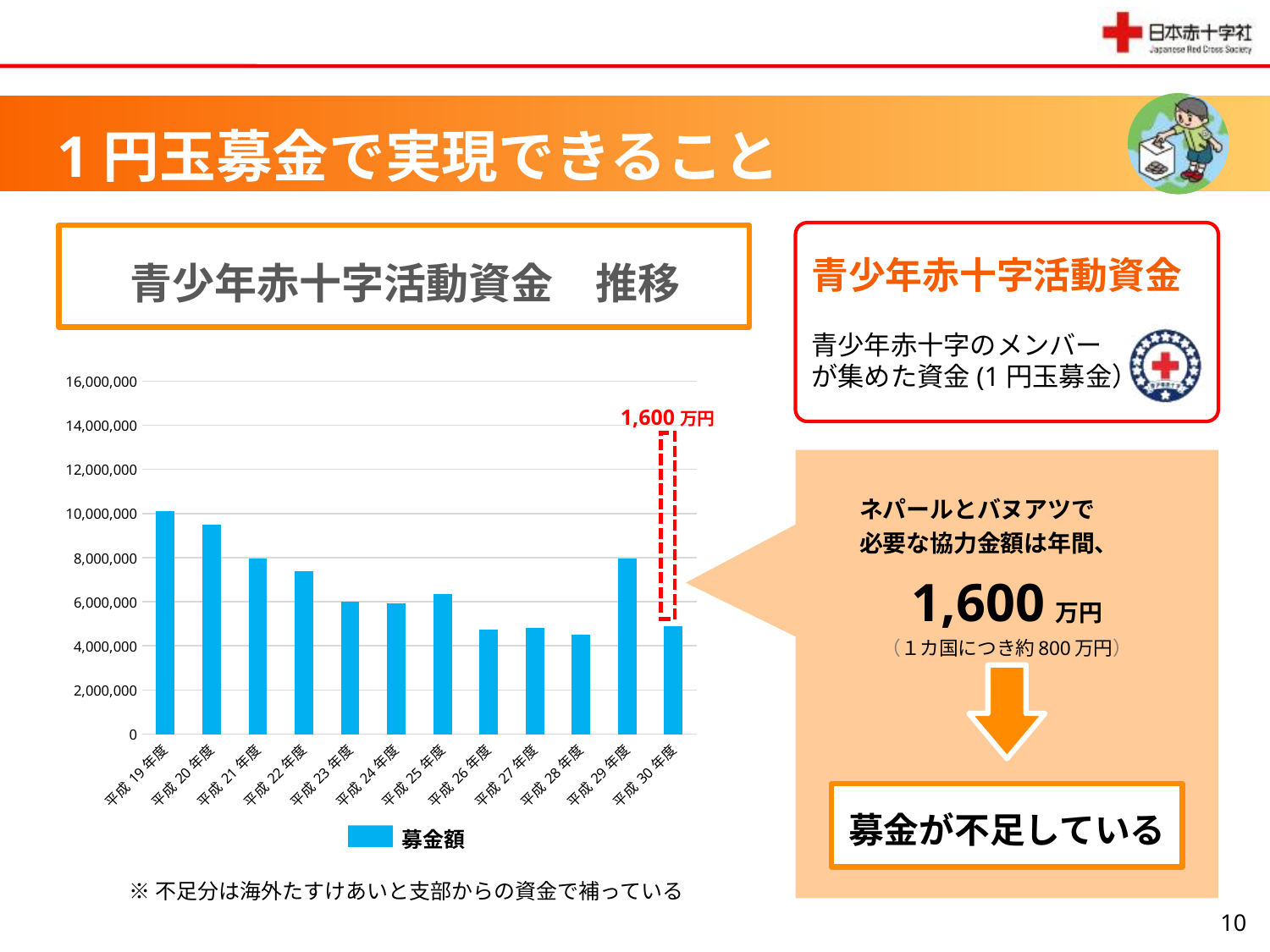
Is the value for 平成28年度 greater or less than 6,000,000? less Is the value for 平成19年度 greater or less than 8,000,000? greater From 平成19年度 to 平成23年度, do the values rise or fall? fall What kind of chart is shown on the slide? bar chart What is the name of the series shown in the chart's legend? 募金額 Is the value for 平成22年度 greater or less than 6,000,000? greater Which fiscal year has the highest value in the chart? 平成19年度 How many fiscal-year categories are plotted on the x axis of the chart? 12 How many series does the chart's legend list? 1 What is the title of the chart? 青少年赤十字活動資金 推移 Which is larger, the value for 平成29年度 or the value for 平成28年度? 平成29年度